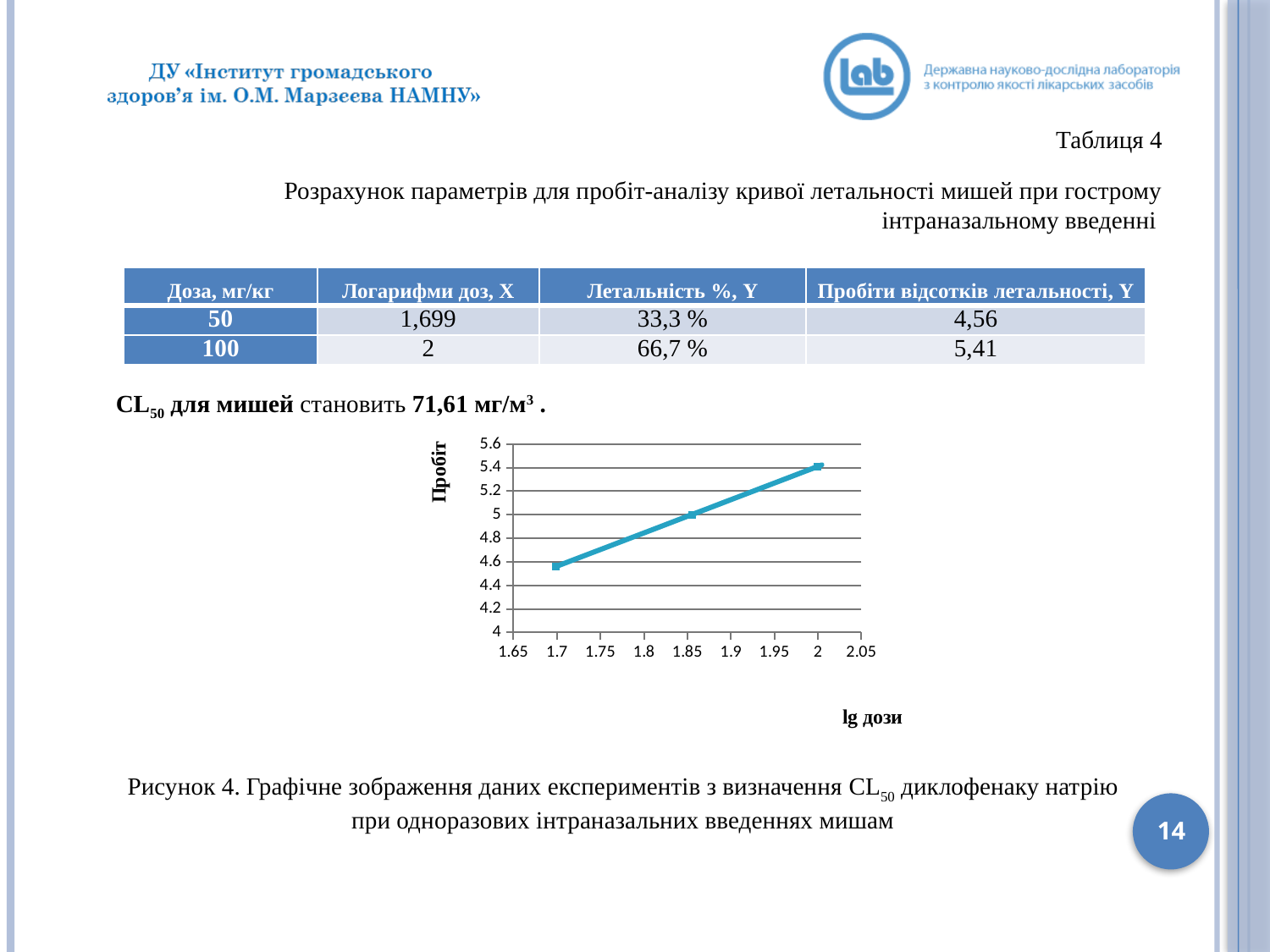
How many data points are plotted on the chart? 3 Is the probit value at lg дози 2 greater or less than 5.6? less Is the probit value at lg дози 2 larger or smaller than the probit value at lg дози 1.7? larger Is the probit value at lg дози 1.7 greater or less than 4.8? less Is the probit value at lg дози 2 greater or less than 5.2? greater Which plotted point has the highest probit value, the one at lg дози 1.7 or the one at lg дози 2? lg дози 2 What is the label of the vertical axis of the chart? Пробіт What kind of chart is shown on the slide? line chart Do the probit values rise or fall as lg дози increases along the x axis? rise What is the label of the horizontal axis of the chart? lg дози Which plotted point has the lowest probit value? the point at lg дози 1.7